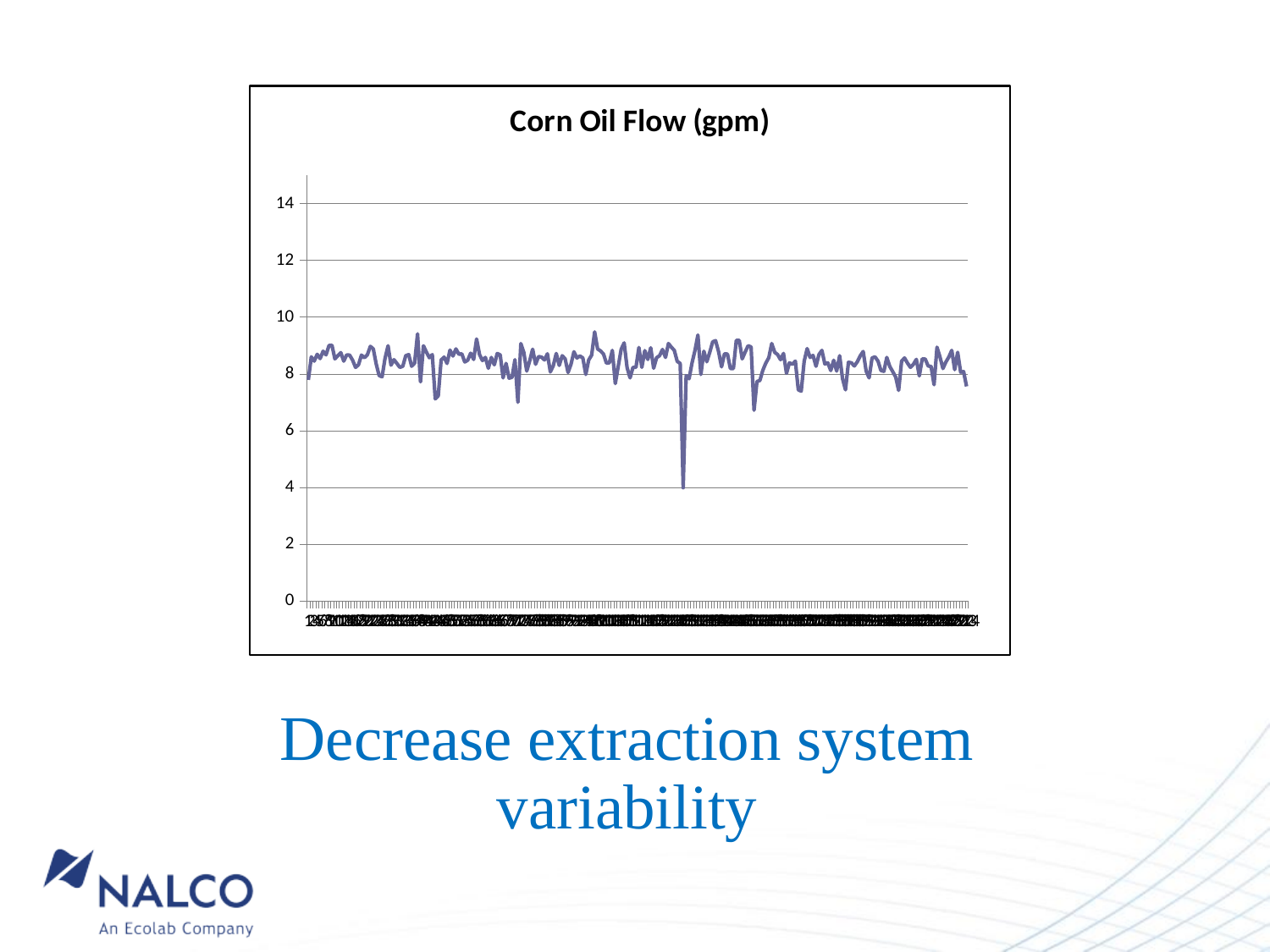
Is the lowest point on the Corn Oil Flow line greater or less than 2? greater What kind of chart is shown on the slide? line chart What is the highest tick value shown on the y axis of the chart? 14 How many lines are plotted on the chart? 1 Are most of the values on the Corn Oil Flow line greater or less than 6? greater Is the lowest point on the Corn Oil Flow line greater or less than 6? less What is the title of the chart? Corn Oil Flow (gpm)